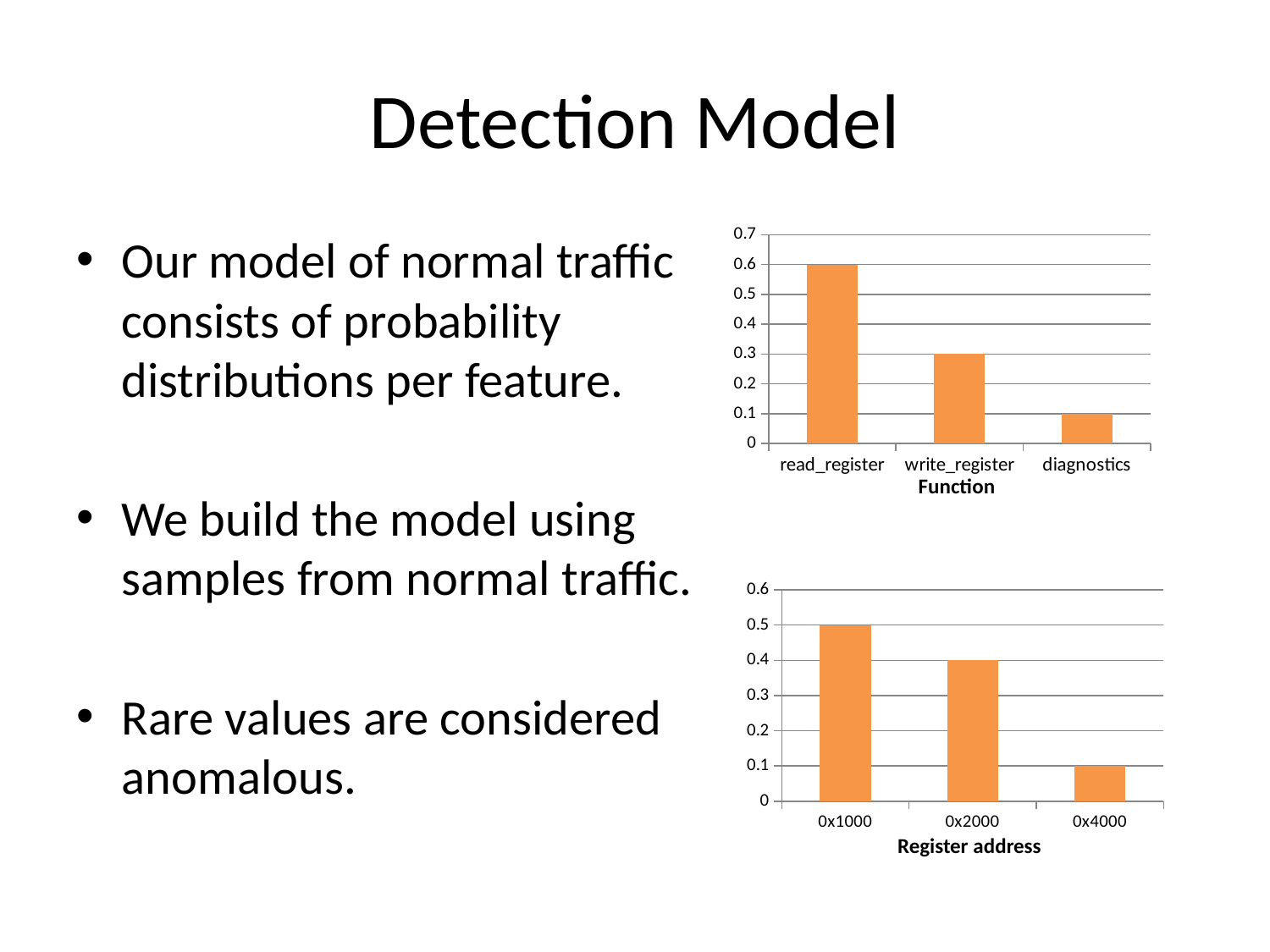
In the Register address chart, which register address has the highest value? 0x1000 In the Register address chart, do the values rise or fall from left to right? fall In the Function chart, what is the difference between read_register and write_register? 0.3 In the Function chart, which function has the highest value? read_register In the Register address chart, is the value for 0x4000 greater or less than 0.2? less In the Function chart, what is the value for read_register? 0.6 In the Function chart, how many functions are shown? 3 In the Register address chart, what is the difference between 0x1000 and 0x4000? 0.4 In the Register address chart, what is the value for 0x2000? 0.4 What kind of chart is the Register address chart? bar chart In the Function chart, what is the value for diagnostics? 0.1 In the Function chart, which function has the lowest value? diagnostics